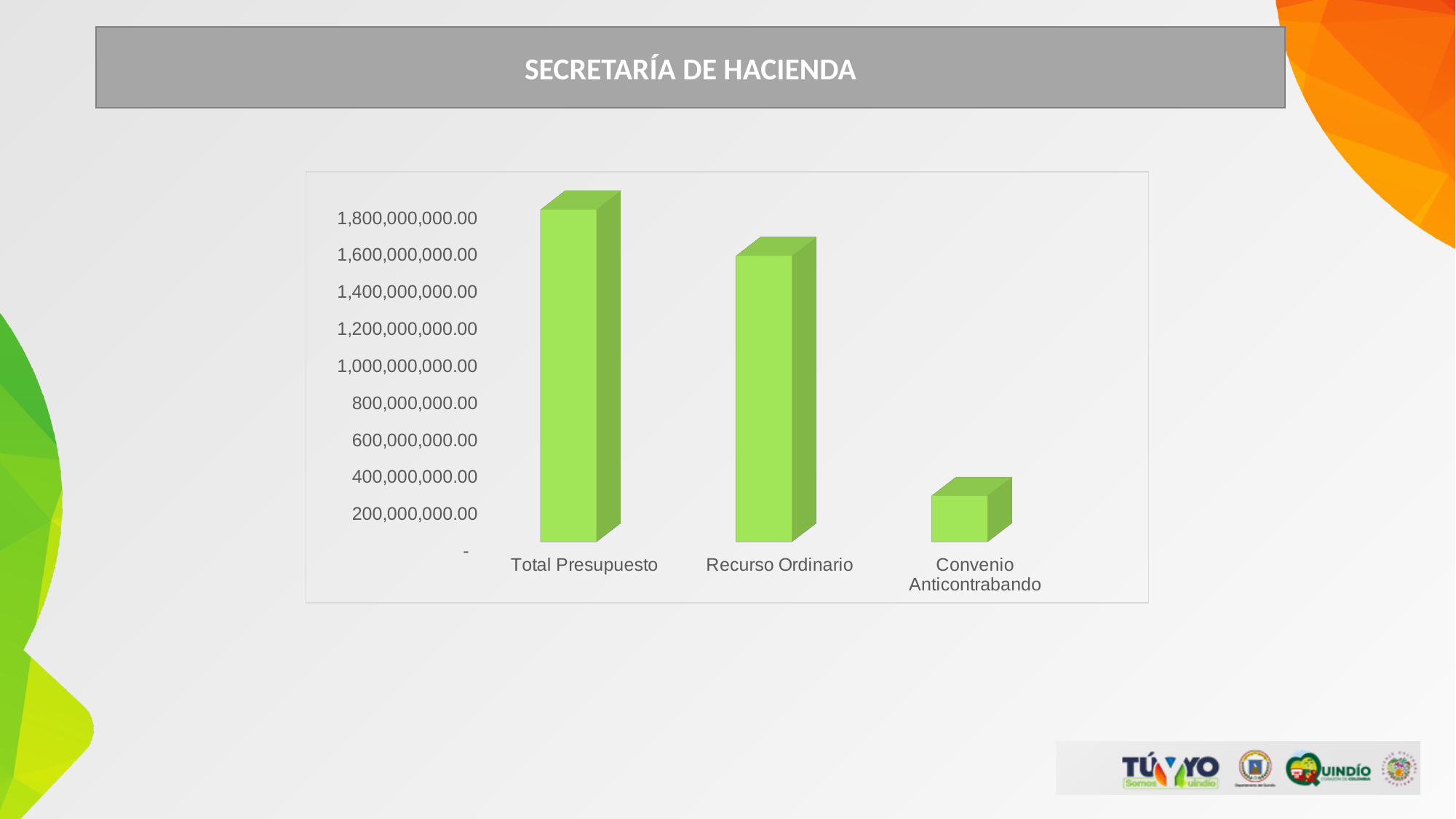
Is the value for Convenio Anticontrabando greater or less than 200,000,000.00? greater What kind of chart is shown on the slide? bar chart Which category has the highest bar in the chart? Total Presupuesto How many categories are plotted in the chart? 3 Do the bar values rise or fall from left to right across the categories? fall Which category has the lowest bar in the chart? Convenio Anticontrabando What is the title shown in the header above the chart? SECRETARÍA DE HACIENDA Is the value for Total Presupuesto greater or less than 1,600,000,000.00? greater Is the value for Recurso Ordinario greater or less than 1,400,000,000.00? greater Which is larger, the value for Total Presupuesto or the value for Recurso Ordinario? Total Presupuesto Which is larger, the value for Recurso Ordinario or the value for Convenio Anticontrabando? Recurso Ordinario